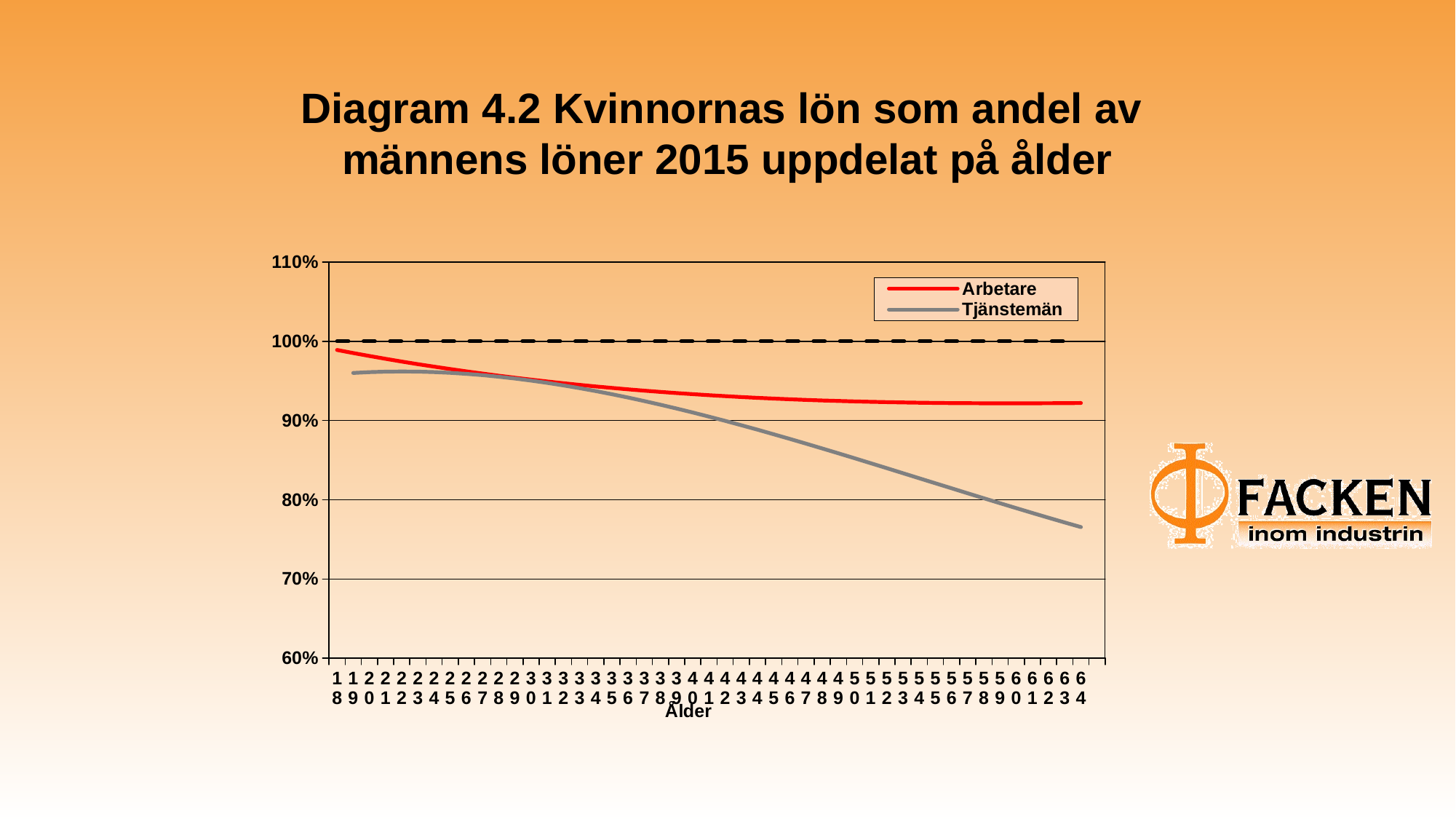
Is the value for Tjänstemän at age 64 greater or less than 80%? less Which two series are listed in the legend? Arbetare and Tjänstemän Is the value for Arbetare at age 64 greater or less than 90%? greater How many ages are shown along the x axis? 47 What is the label of the x axis? Ålder Does the Tjänstemän line rise or fall as age increases along the x axis? Fall What kind of chart is shown on the slide? Line chart Is the value for Tjänstemän at age 50 greater or less than 90%? less Does the Arbetare line rise or fall overall from age 18 to age 64? Fall At age 64, which series has the higher value, Arbetare or Tjänstemän? Arbetare How many series does the legend list? 2